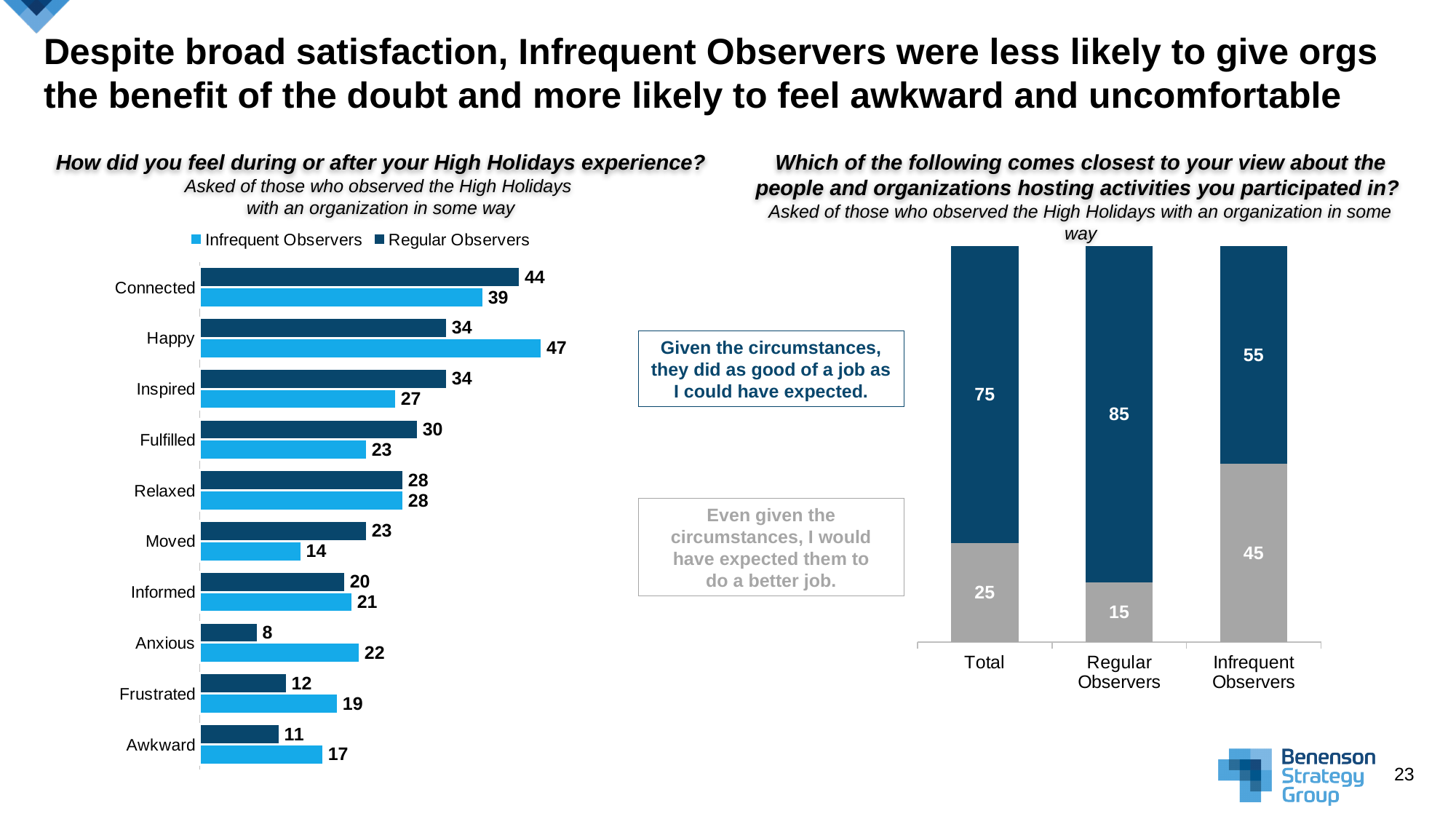
What kind of chart is the right chart 'Which of the following comes closest to your view about the people and organizations hosting activities you participated in?'? Stacked bar chart In the left chart 'How did you feel during or after your High Holidays experience?', how many series does the legend list? 2 In the left chart 'How did you feel during or after your High Holidays experience?', which feeling has the highest value for Infrequent Observers? Happy In the right chart 'Which of the following comes closest to your view about the people and organizations hosting activities you participated in?', what is the total of the Regular Observers bar? 100 In the left chart 'How did you feel during or after your High Holidays experience?', which is larger for Moved: Infrequent Observers or Regular Observers? Regular Observers In the right chart 'Which of the following comes closest to your view about the people and organizations hosting activities you participated in?', what is the difference between Infrequent Observers and Regular Observers for 'Even given the circumstances, I would have expected them to do a better job'? 30 In the left chart 'How did you feel during or after your High Holidays experience?', what is the value for Infrequent Observers for Happy? 47 In the right chart 'Which of the following comes closest to your view about the people and organizations hosting activities you participated in?', what is the value for Infrequent Observers who said 'Given the circumstances, they did as good of a job as I could have expected'? 55 In the left chart 'How did you feel during or after your High Holidays experience?', what is the difference between Infrequent Observers and Regular Observers for Anxious? 14 In the left chart 'How did you feel during or after your High Holidays experience?', which feeling has the lowest value for Regular Observers? Anxious In the left chart 'How did you feel during or after your High Holidays experience?', how many feelings are listed? 10 In the left chart 'How did you feel during or after your High Holidays experience?', what is the value for Regular Observers for Connected? 44